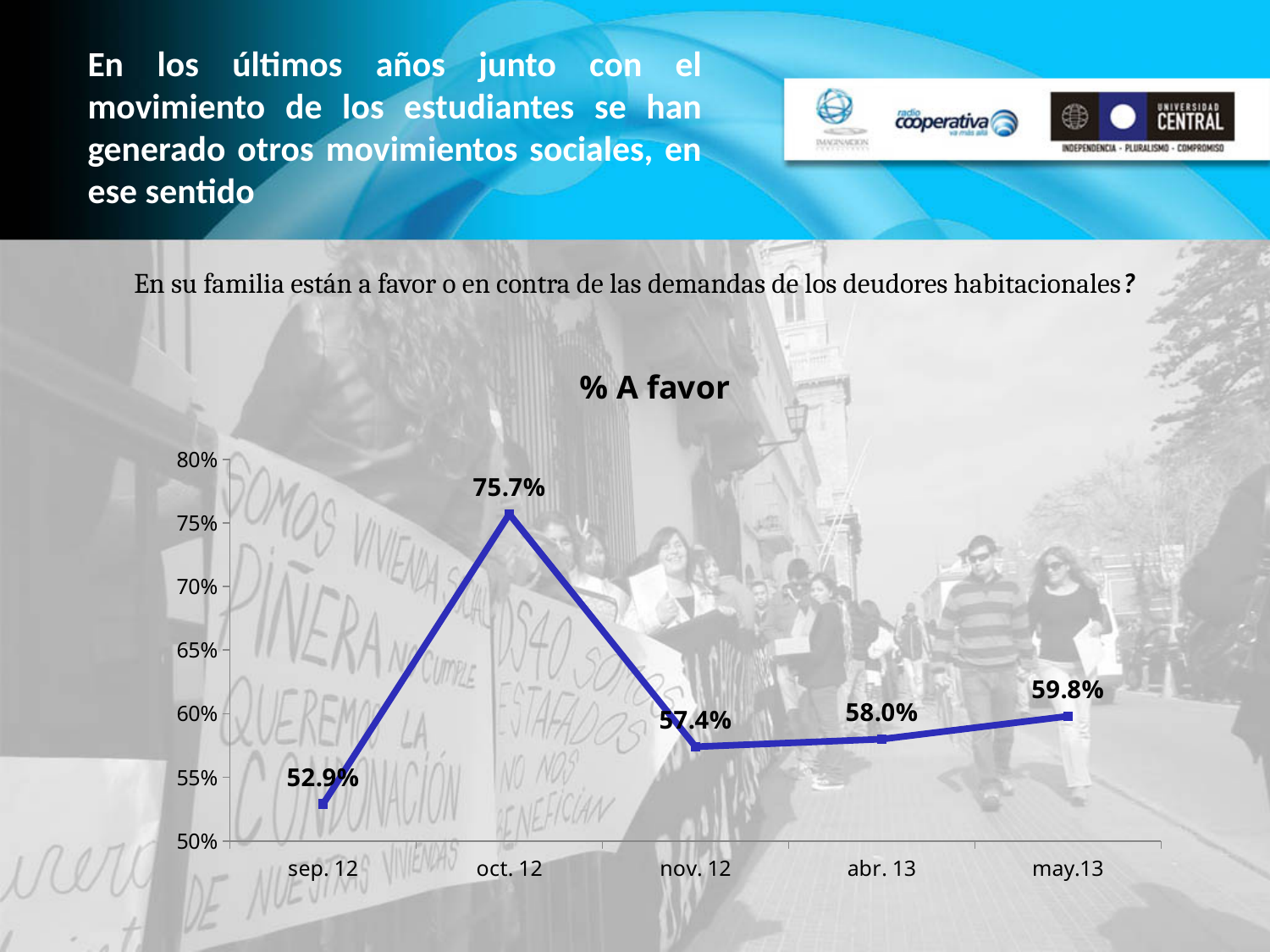
What is the difference between the values for oct. 12 and nov. 12? 18.3% What is the value for sep. 12? 52.9% Which period has the lowest value? sep. 12 Is the value for nov. 12 greater or less than 60%? less How many periods are plotted on the chart? 5 Which is larger, the value for abr. 13 or the value for may.13? may.13 What kind of chart is shown? line chart What is the value for may.13? 59.8% Which period has the highest value? oct. 12 What is the value for abr. 13? 58.0% What is the value for oct. 12? 75.7% What is the title of the chart? % A favor